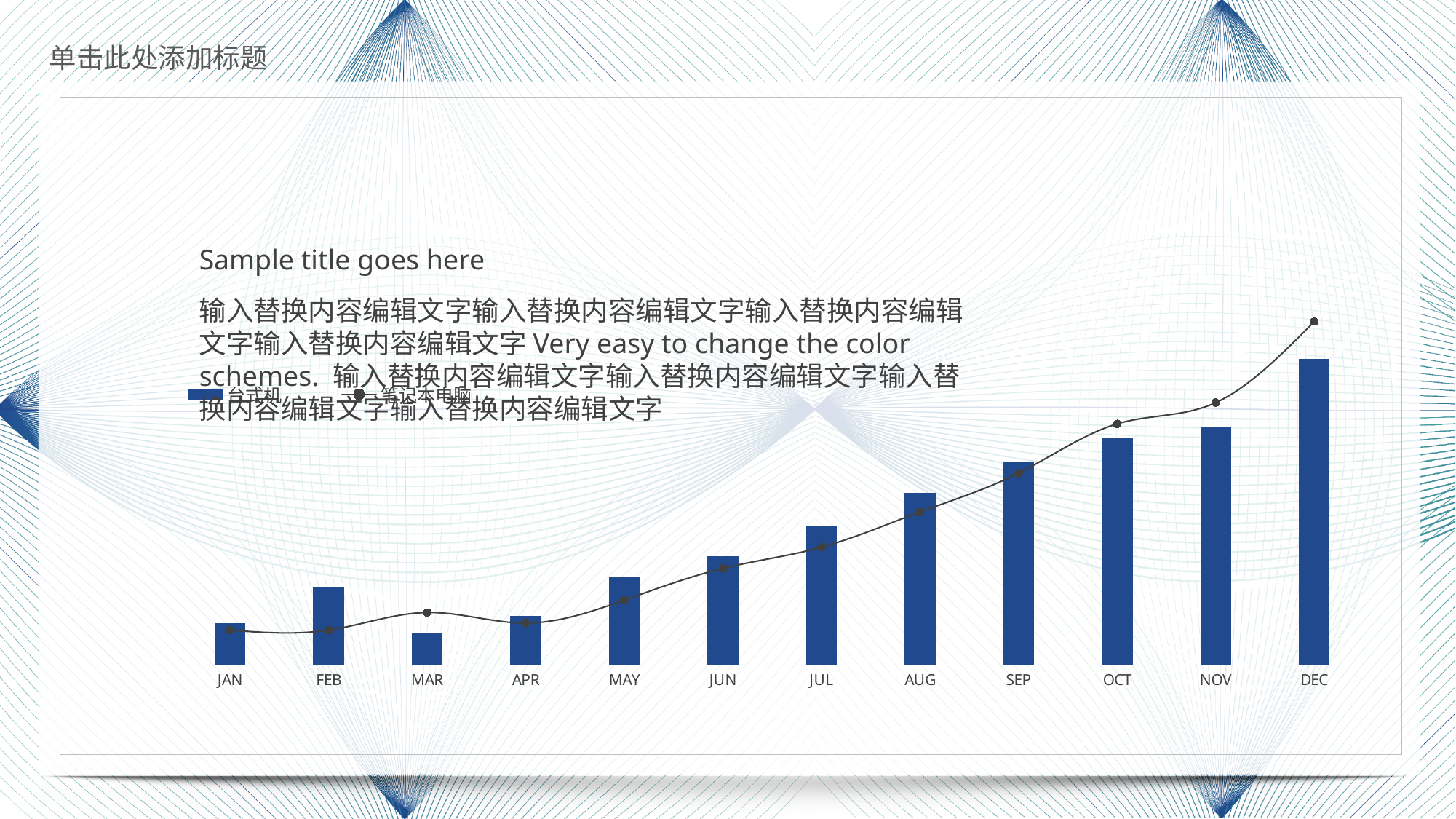
Which month has the lowest point on the line series? JAN and FEB (tied) Is the bar for FEB taller or shorter than the bar for MAR? taller Which series is shown as bars in the chart? 台式机 What kind of chart is shown on the slide? Combined bar and line chart Which month has the tallest bar in the chart? DEC How many categories are shown on the x axis of the chart? 12 Is the bar for DEC taller or shorter than the bar for JAN? taller How many series does the chart's legend list? 2 Do the bar values generally rise or fall from JAN to DEC? rise Which month has the shortest bar in the chart? MAR Which series is shown as a line in the chart? 笔记本电脑 Which month has the highest point on the line series? DEC